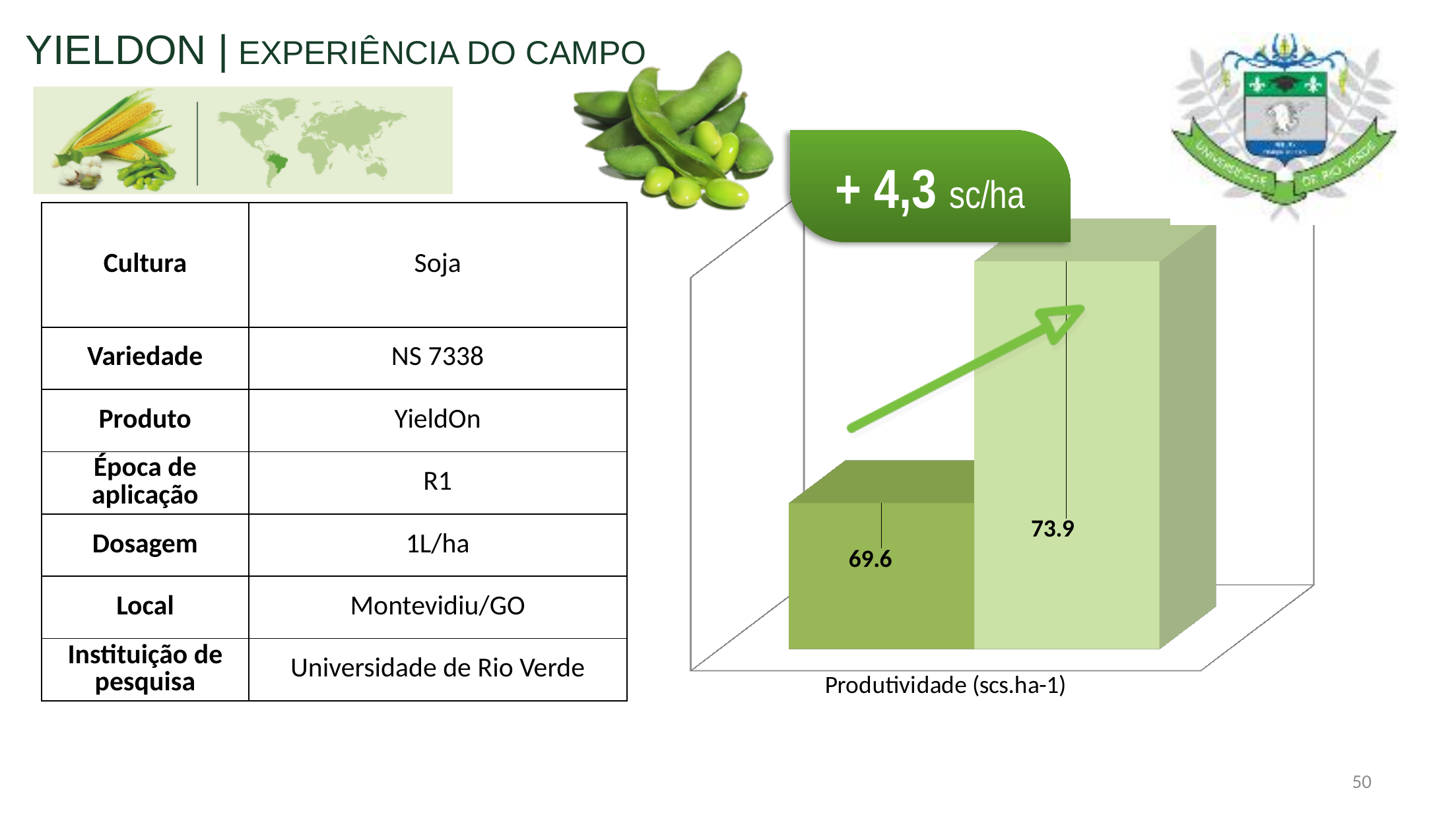
Is the value of the right bar larger or smaller than the value of the left bar? Larger What is the category label shown beneath the bars on the chart's x axis? Produtividade (scs.ha-1) What kind of chart is shown on the slide? Bar chart How many bars are plotted in the chart? 2 What value is printed on the right, lighter green bar of the chart? 73.9 What value is printed on the left, darker green bar of the chart? 69.6 Which bar in the chart has the highest value? The right, lighter green bar (73.9) What gain is stated in the green callout above the chart? + 4,3 sc/ha What is the difference between the two bar values shown in the chart (73.9 and 69.6)? 4.3 Which bar in the chart has the lowest value? The left, darker green bar (69.6)